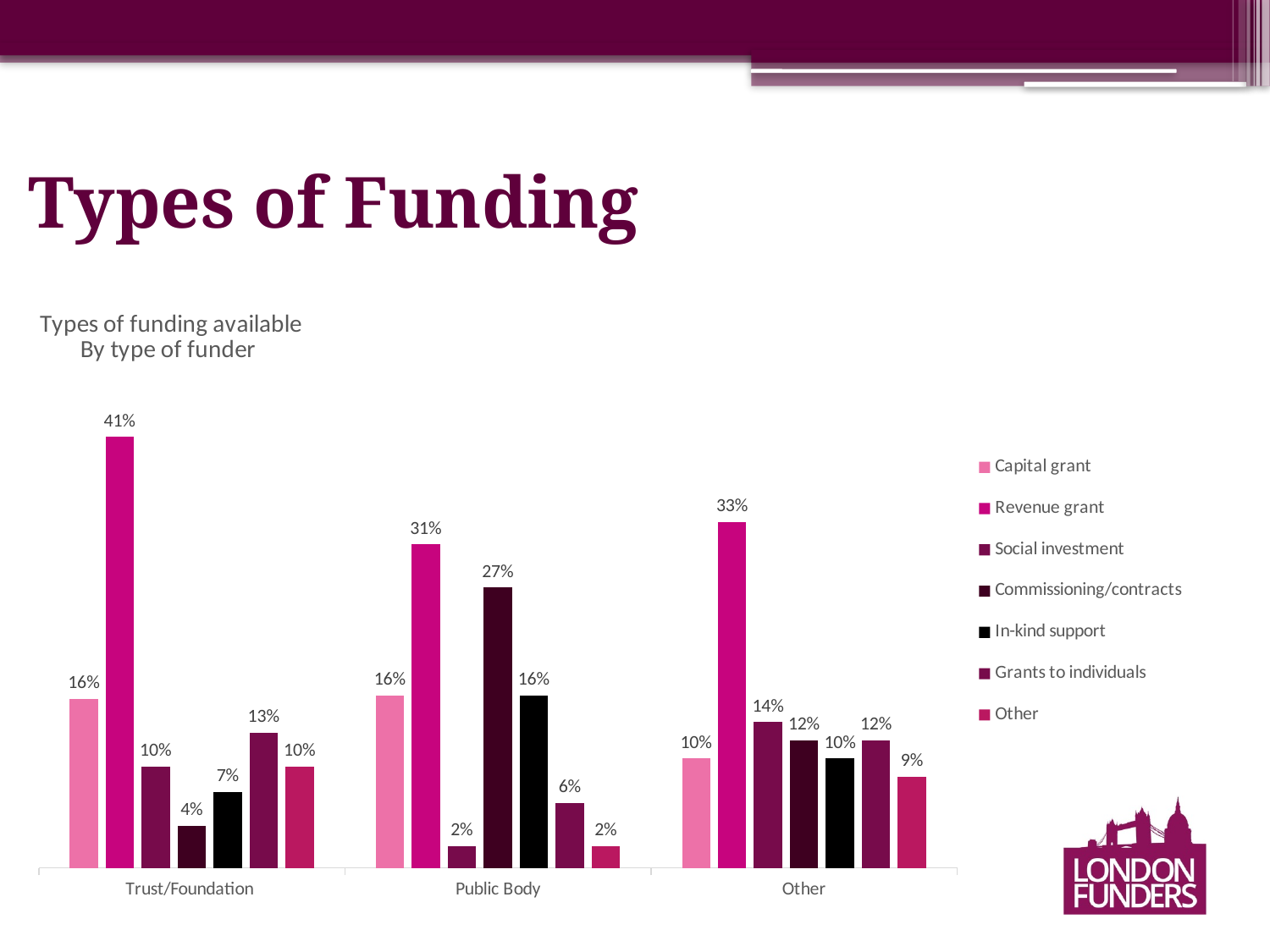
Which funding type has the highest value in the Public Body category? Revenue grant Which funding type has the lowest value in the Trust/Foundation category? Commissioning/contracts What kind of chart is shown on the slide? Bar chart What is the difference between the In-kind support values for Public Body and Trust/Foundation? 9% What is the difference between the Revenue grant values for Trust/Foundation and Other? 8% What is the value for Commissioning/contracts in the Public Body category? 27% Which is larger: Commissioning/contracts for Public Body or Commissioning/contracts for Other? Public Body How many funder categories are shown on the x axis? 3 What is the value for Social investment in the Other category? 14% What is the value for Revenue grant in the Trust/Foundation category? 41% How many series does the legend list? 7 What is the title of the chart? Types of funding available By type of funder